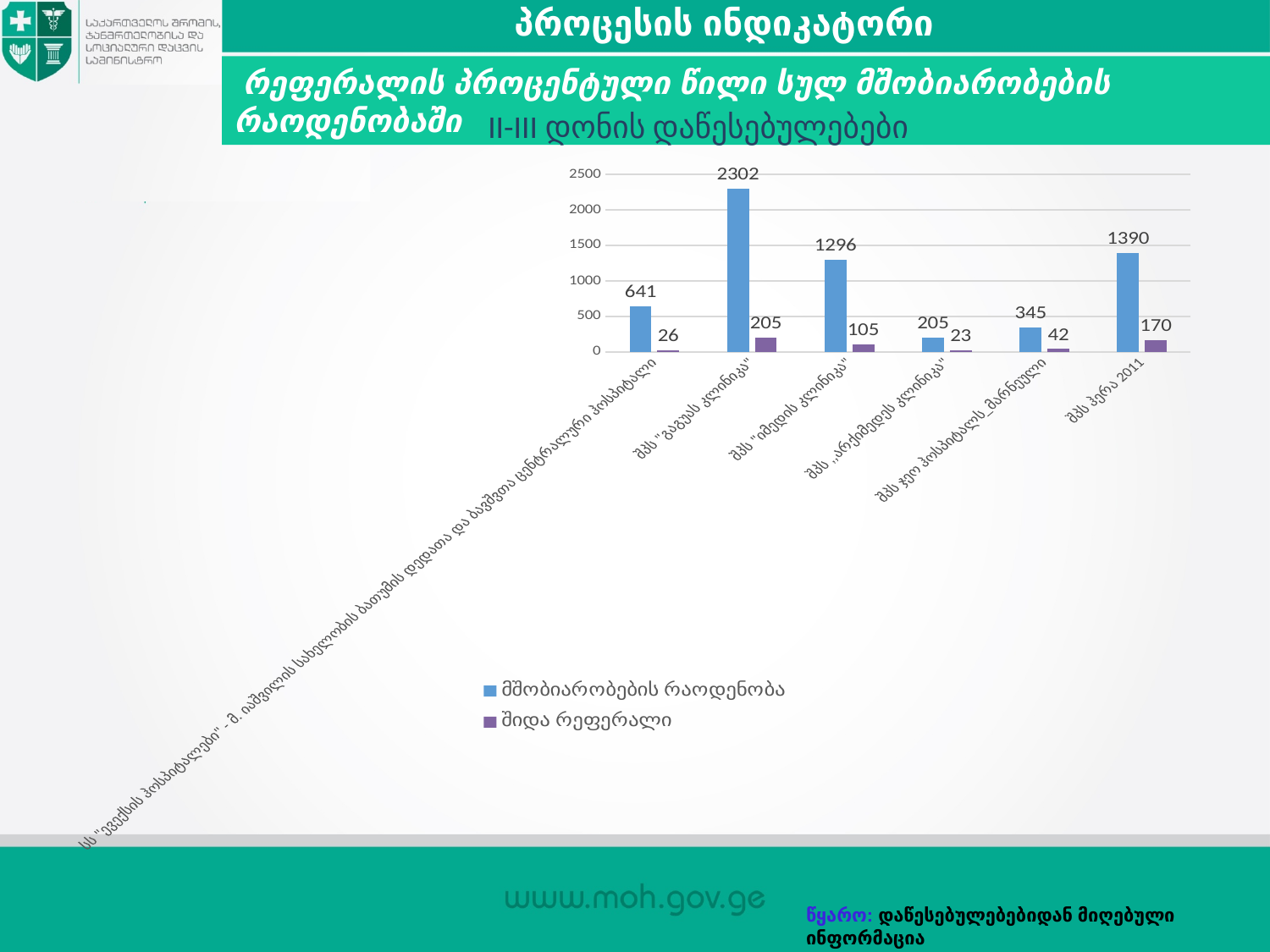
How many categories (facilities) are shown on the x axis? 6 Which category has the highest value for მშობიარობების რაოდენობა? შპს "გაგუას კლინიკა" How many series does the legend list? 2 Which category has the lowest value for მშობიარობების რაოდენობა? შპს ,,არქიმედეს კლინიკა" Is the value of მშობიარობების რაოდენობა for შპს ჯეო ჰოსპიტალს_მარნეული greater or less than 500? less What is the value of მშობიარობების რაოდენობა for შპს "გაგუას კლინიკა"? 2302 What kind of chart is shown on the slide? bar chart Which colour represents შიდა რეფერალი in the legend? purple What is the value of შიდა რეფერალი for შპს "იმედის კლინიკა"? 105